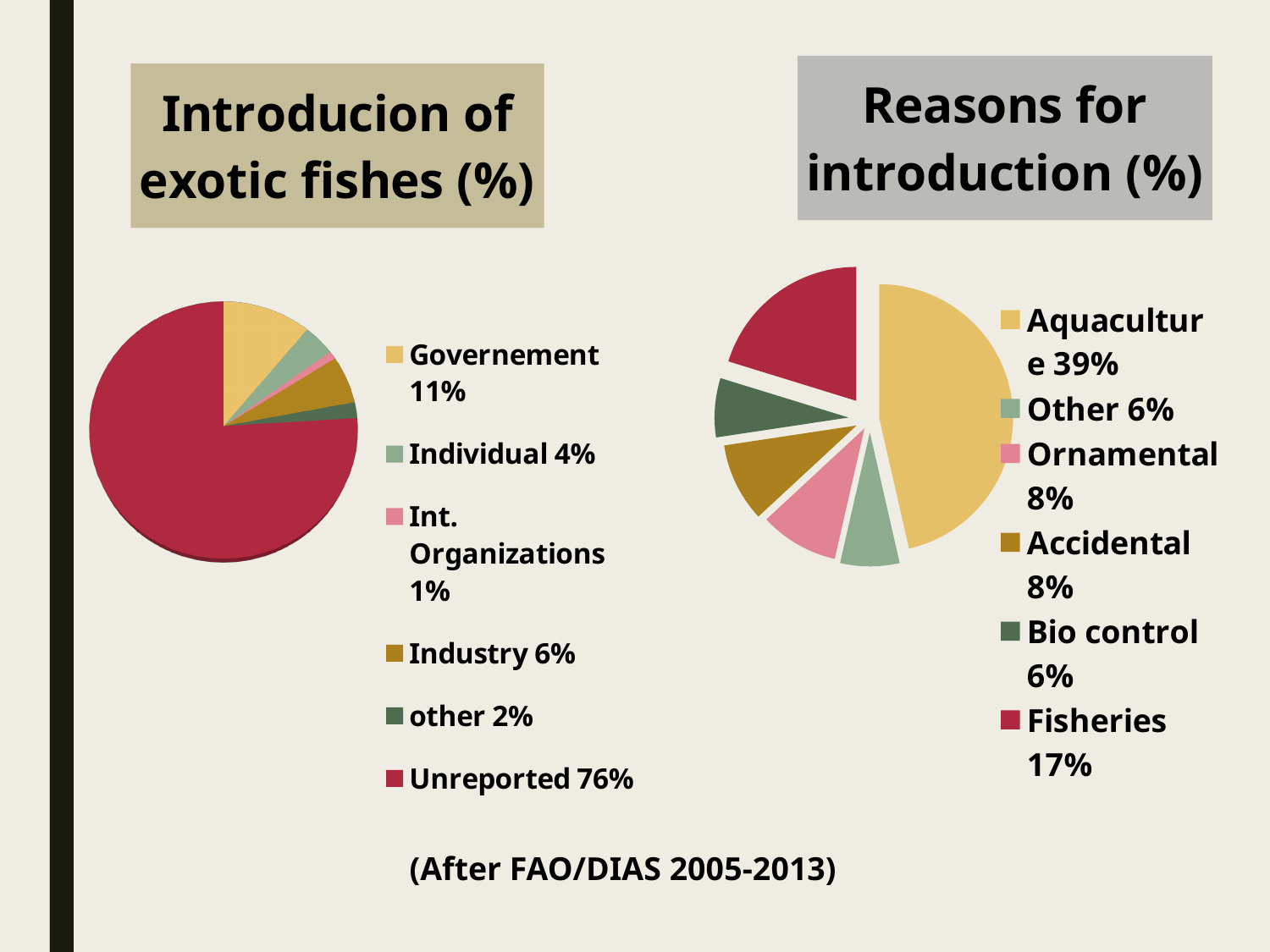
In the 'Introducion of exotic fishes (%)' chart, how many categories does the legend list? 6 In the 'Reasons for introduction (%)' chart, which reason has the largest share? Aquaculture In the 'Introducion of exotic fishes (%)' chart, what percentage is Unreported? 76% In the 'Reasons for introduction (%)' chart, what percentage is Aquaculture? 39% In the 'Introducion of exotic fishes (%)' chart, which is larger, Individual or other? Individual In the 'Reasons for introduction (%)' chart, what is the difference between Aquaculture and Fisheries? 22% In the 'Introducion of exotic fishes (%)' chart, what is the difference between Governement and Industry? 5% What type of chart is used on the left of the slide, titled 'Introducion of exotic fishes (%)'? Pie chart In the 'Introducion of exotic fishes (%)' chart, which category has the smallest share? Int. Organizations In the 'Reasons for introduction (%)' chart, what percentage is Fisheries? 17% In the 'Introducion of exotic fishes (%)' chart, what percentage is Governement? 11% In the 'Reasons for introduction (%)' chart, which colour represents Bio control? Dark green